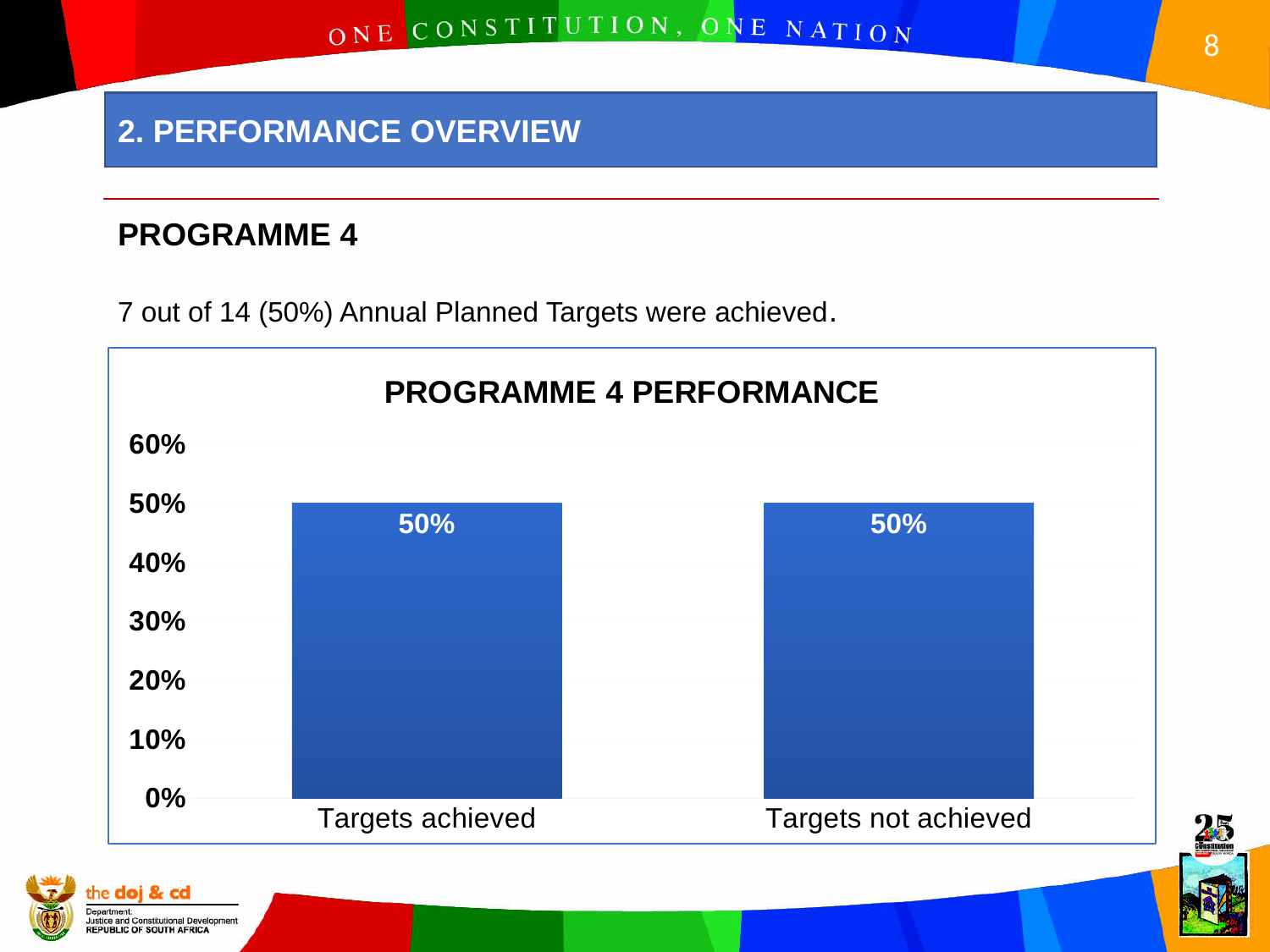
How many categories are shown on the x axis? 2 What kind of chart is shown? bar chart What is the title of the chart? PROGRAMME 4 PERFORMANCE Is the value for Targets not achieved greater or less than 60%? less What is the value for Targets not achieved? 50% What is the total of the two bars' values? 100% What is the highest value shown on the y axis? 60% What is the value for Targets achieved? 50% Is the value for Targets achieved greater or less than 40%? greater What is the difference between the values for Targets achieved and Targets not achieved? 0%